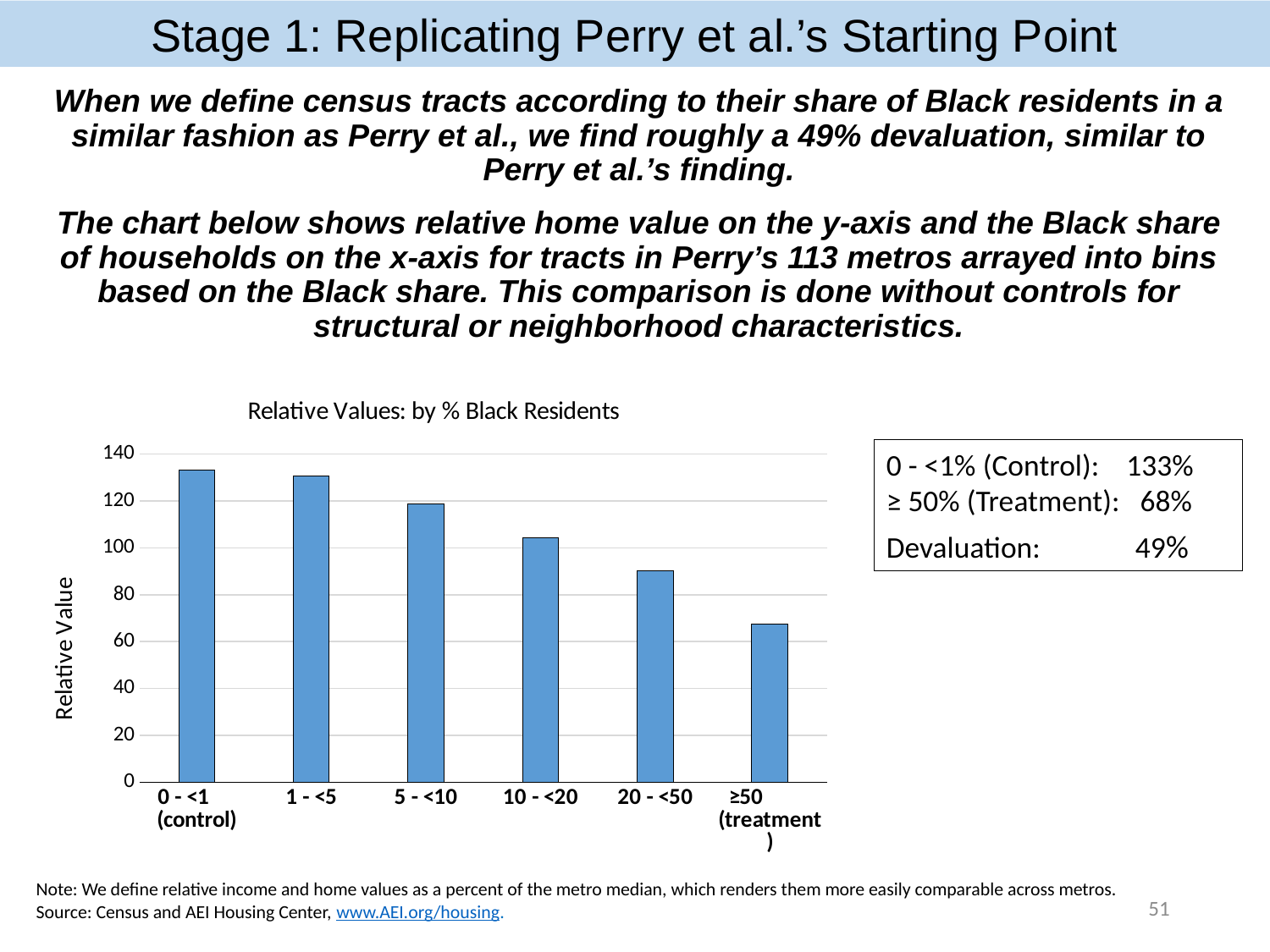
What kind of chart is shown on the slide? bar chart How many bins (categories) are shown on the x-axis of the chart? 6 Is the relative value for the ≥50 (treatment) bin greater or less than 80? less Is the relative value for the 1 - <5 bin greater or less than 120? greater What is the label on the y-axis of the chart? Relative Value Which bin has the highest relative value? 0 - <1 (control) Which bin has the lowest relative value? ≥50 (treatment) According to the text box next to the chart, what is the relative value for the 0 - <1% (Control) bin? 133% What is the title of the chart? Relative Values: by % Black Residents Which bin has a larger relative value, 1 - <5 or 10 - <20? 1 - <5 Do the relative values rise or fall as the Black share bins increase along the x-axis? fall Is the relative value for the 20 - <50 bin greater or less than 100? less